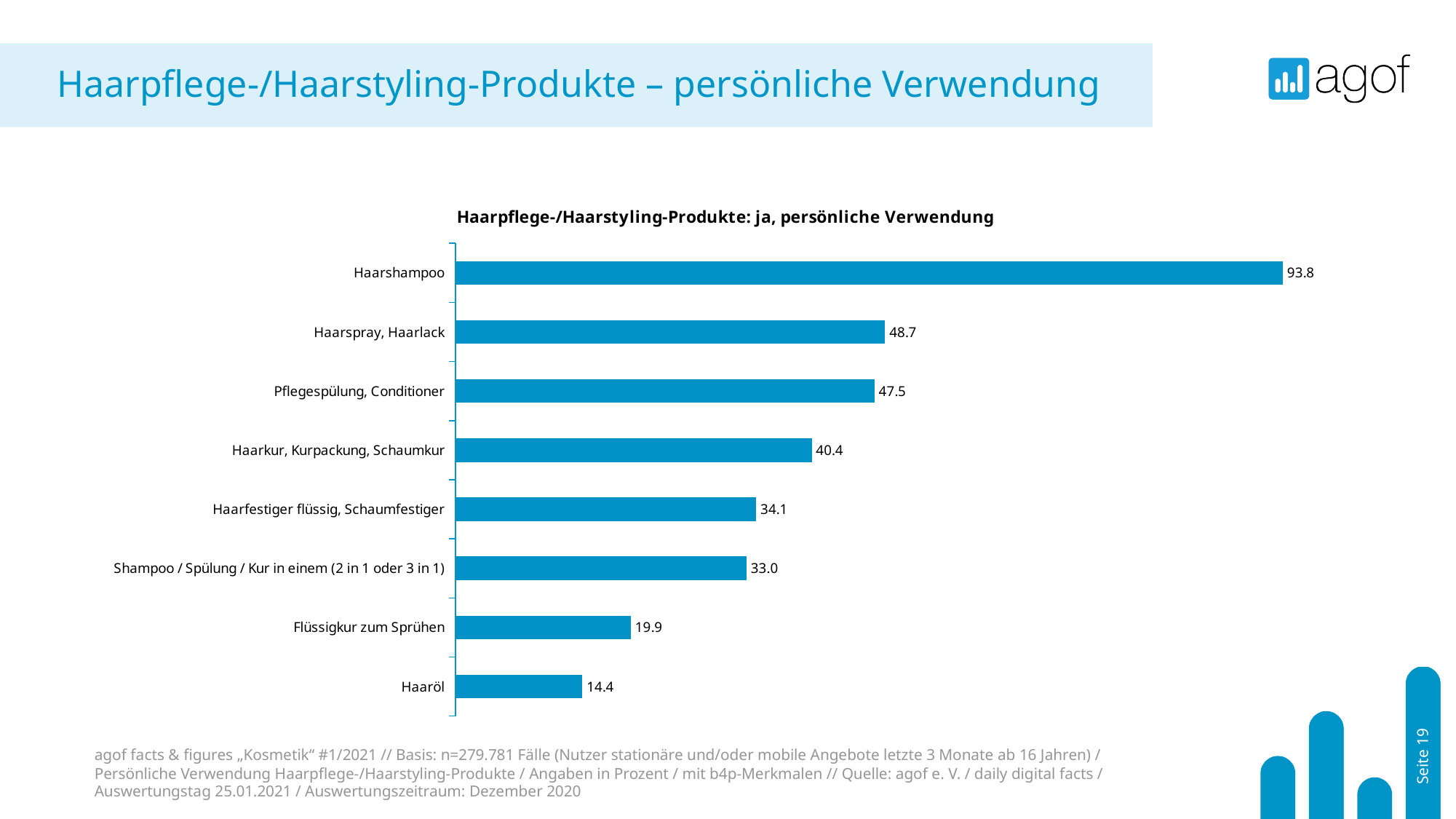
What is the value for Haarkur, Kurpackung, Schaumkur? 40.4 Which is larger, the value for Haarkur, Kurpackung, Schaumkur or the value for Haarfestiger flüssig, Schaumfestiger? Haarkur, Kurpackung, Schaumkur What is the difference between the values for Haarfestiger flüssig, Schaumfestiger and Shampoo / Spülung / Kur in einem (2 in 1 oder 3 in 1)? 1.1 What is the value for Flüssigkur zum Sprühen? 19.9 How many categories are shown in the chart? 8 What is the difference between the values for Haarshampoo and Haarspray, Haarlack? 45.1 What is the value for Haarshampoo? 93.8 What is the title of the chart? Haarpflege-/Haarstyling-Produkte: ja, persönliche Verwendung What is the value for Pflegespülung, Conditioner? 47.5 Which category has the highest value? Haarshampoo Which category has the lowest value? Haaröl What kind of chart is shown on the slide? Bar chart